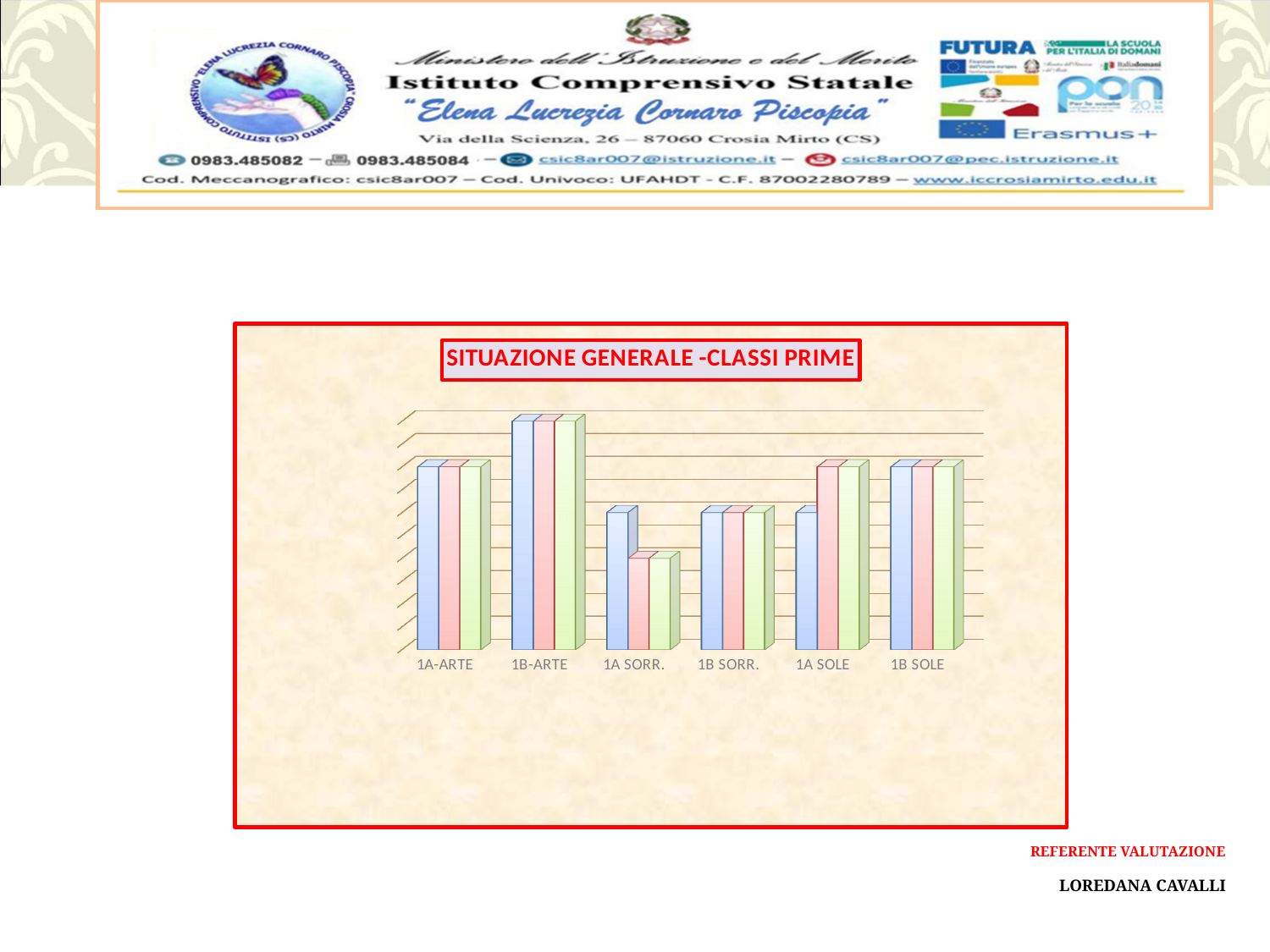
Which category has taller bars, 1A-ARTE or 1A SORR.? 1A-ARTE Which category has taller bars, 1B SORR. or 1B SOLE? 1B SOLE Which category has taller bars, 1A-ARTE or 1B-ARTE? 1B-ARTE What is the title of the chart? SITUAZIONE GENERALE -CLASSI PRIME How many bars are drawn for each category in the chart? 3 Which category has the tallest bars in the chart? 1B-ARTE What is the label of the first category on the x axis? 1A-ARTE Which category contains the shortest bar in the chart? 1A SORR. What is the label of the last category on the x axis? 1B SOLE How many categories are shown on the x axis of the chart? 6 What kind of chart is shown on the slide? Bar chart